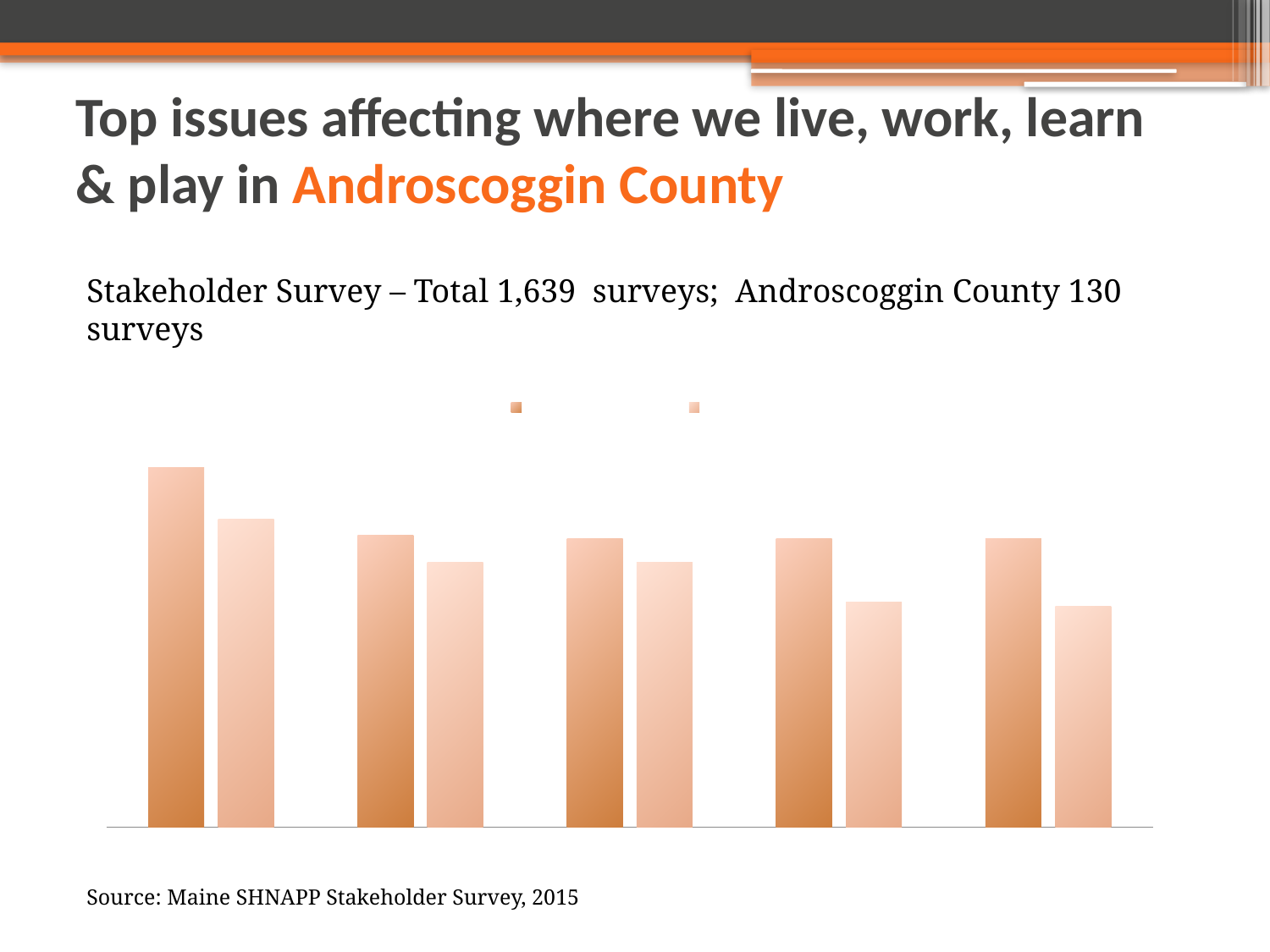
How many bars are plotted in total in the chart? 10 Which group of bars, counting from the left, contains the tallest bar in the chart? the first group What kind of chart is shown on the slide? bar chart How many series does the chart's legend list? 2 How many groups of bars are plotted in the chart? 5 In each group of bars, is the darker orange bar taller or shorter than the lighter bar next to it? taller